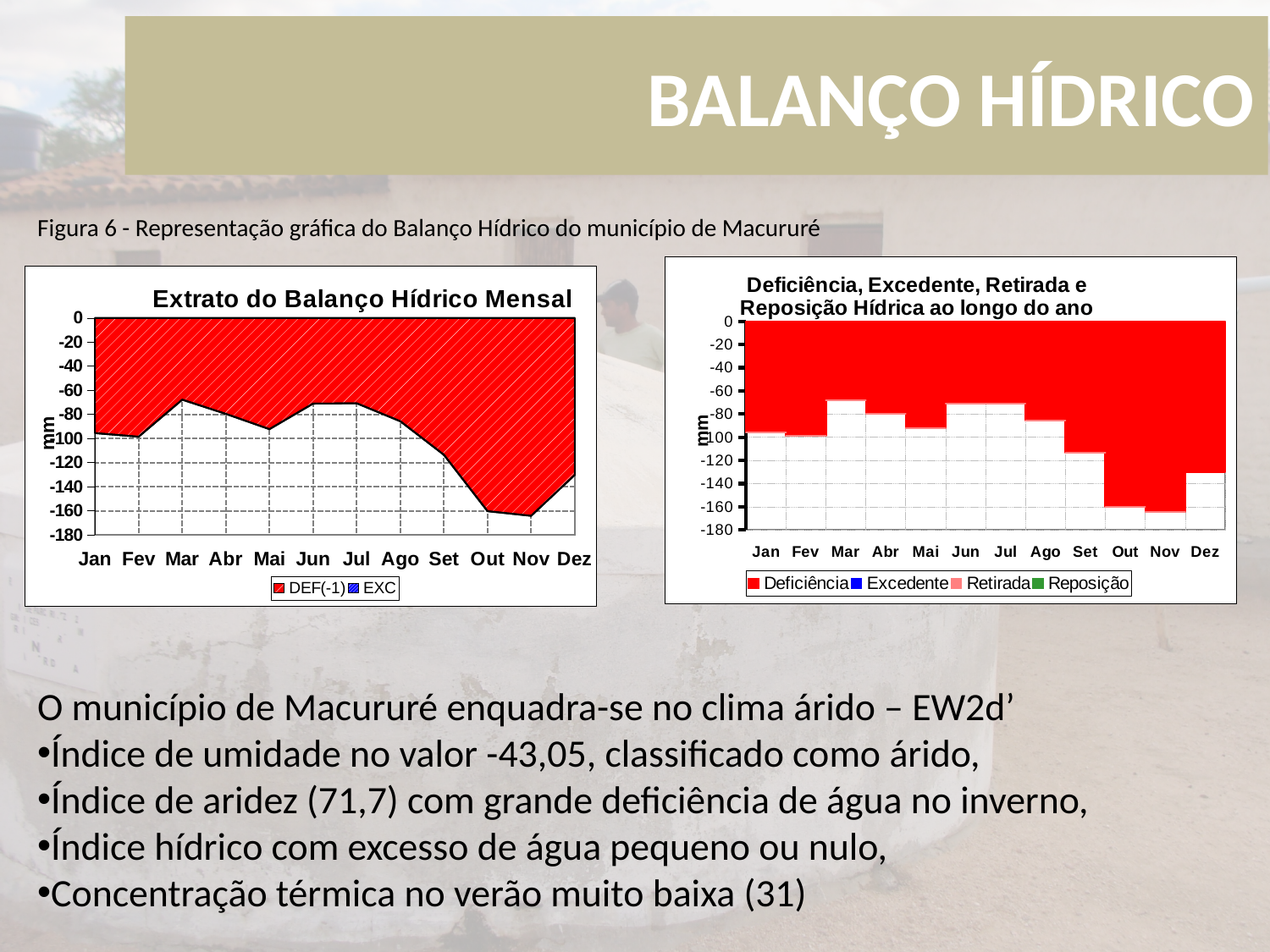
In the right-hand chart, 'Deficiência, Excedente, Retirada e Reposição Hídrica ao longo do ano', is the value for Mar greater or less than -80? greater How many series does the legend of the left-hand chart, 'Extrato do Balanço Hídrico Mensal', list? 2 In the left-hand chart, 'Extrato do Balanço Hídrico Mensal', do the values rise or fall from Ago to Nov? fall How many months are shown on the x axis of the left-hand chart, 'Extrato do Balanço Hídrico Mensal'? 12 In the left-hand chart, 'Extrato do Balanço Hídrico Mensal', is the value for Set greater or less than -100? less What is the unit shown on the y axis of the right-hand chart, 'Deficiência, Excedente, Retirada e Reposição Hídrica ao longo do ano'? mm What kind of chart is the left-hand chart, 'Extrato do Balanço Hídrico Mensal'? area chart In the left-hand chart, 'Extrato do Balanço Hídrico Mensal', is the value for Jan greater or less than -80? less In the right-hand chart, 'Deficiência, Excedente, Retirada e Reposição Hídrica ao longo do ano', which is larger, the value for Mar or the value for Out? Mar What kind of chart is the right-hand chart, 'Deficiência, Excedente, Retirada e Reposição Hídrica ao longo do ano'? bar chart How many series does the legend of the right-hand chart, 'Deficiência, Excedente, Retirada e Reposição Hídrica ao longo do ano', list? 4